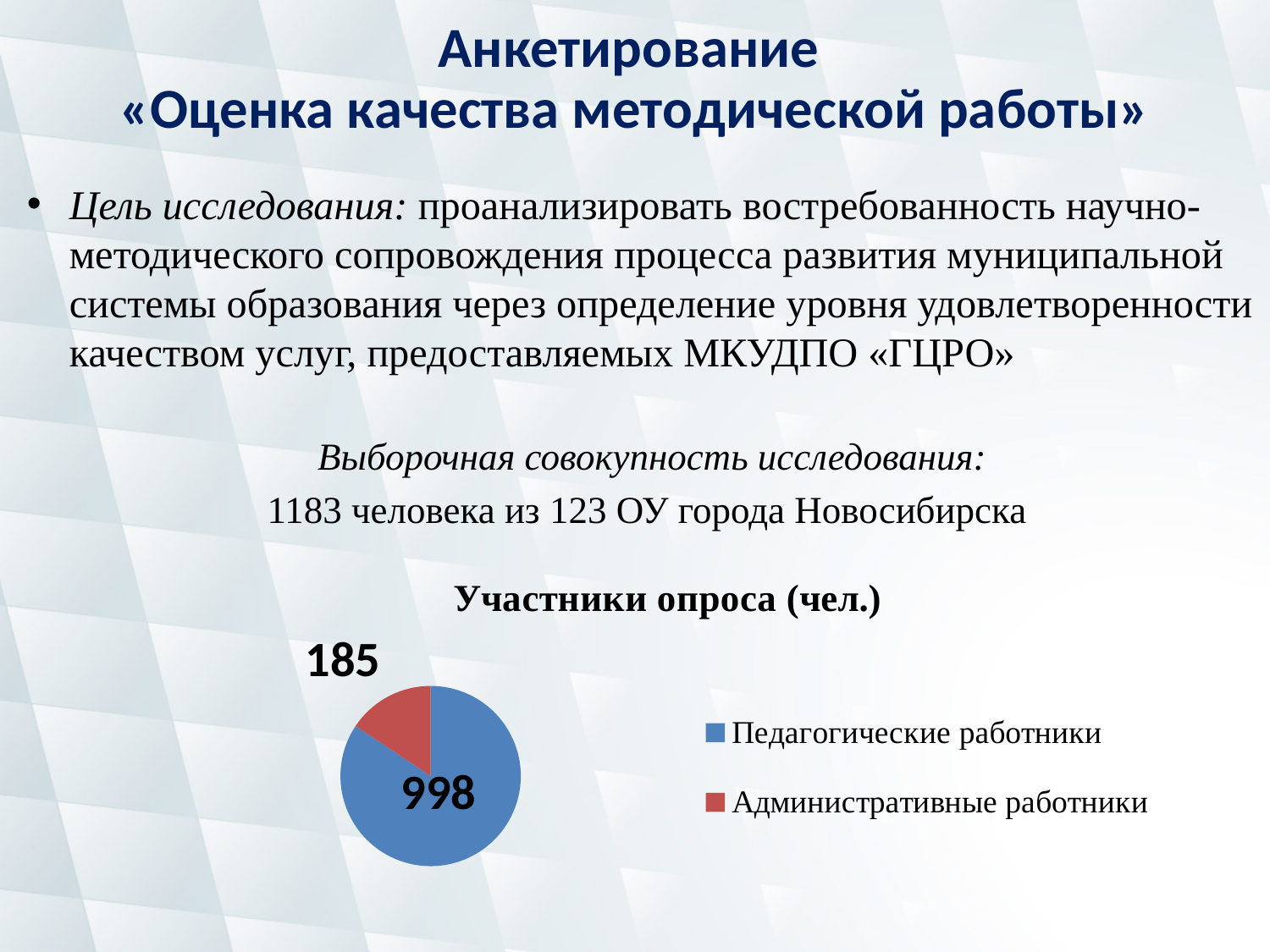
What type of chart is shown on the slide? pie chart What is the value for Педагогические работники? 998 How many slices does the pie chart have? 2 Which category has the largest slice? Педагогические работники What is the chart's title? Участники опроса (чел.) Which is larger: the value for Педагогические работники or for Административные работники? Педагогические работники What is the total of the two slices in the pie chart? 1183 Which category has the smallest slice? Административные работники How many entries does the legend list? 2 What is the difference between the values for Педагогические работники and Административные работники? 813 Which colour represents Административные работники in the pie chart? red What is the value for Административные работники? 185